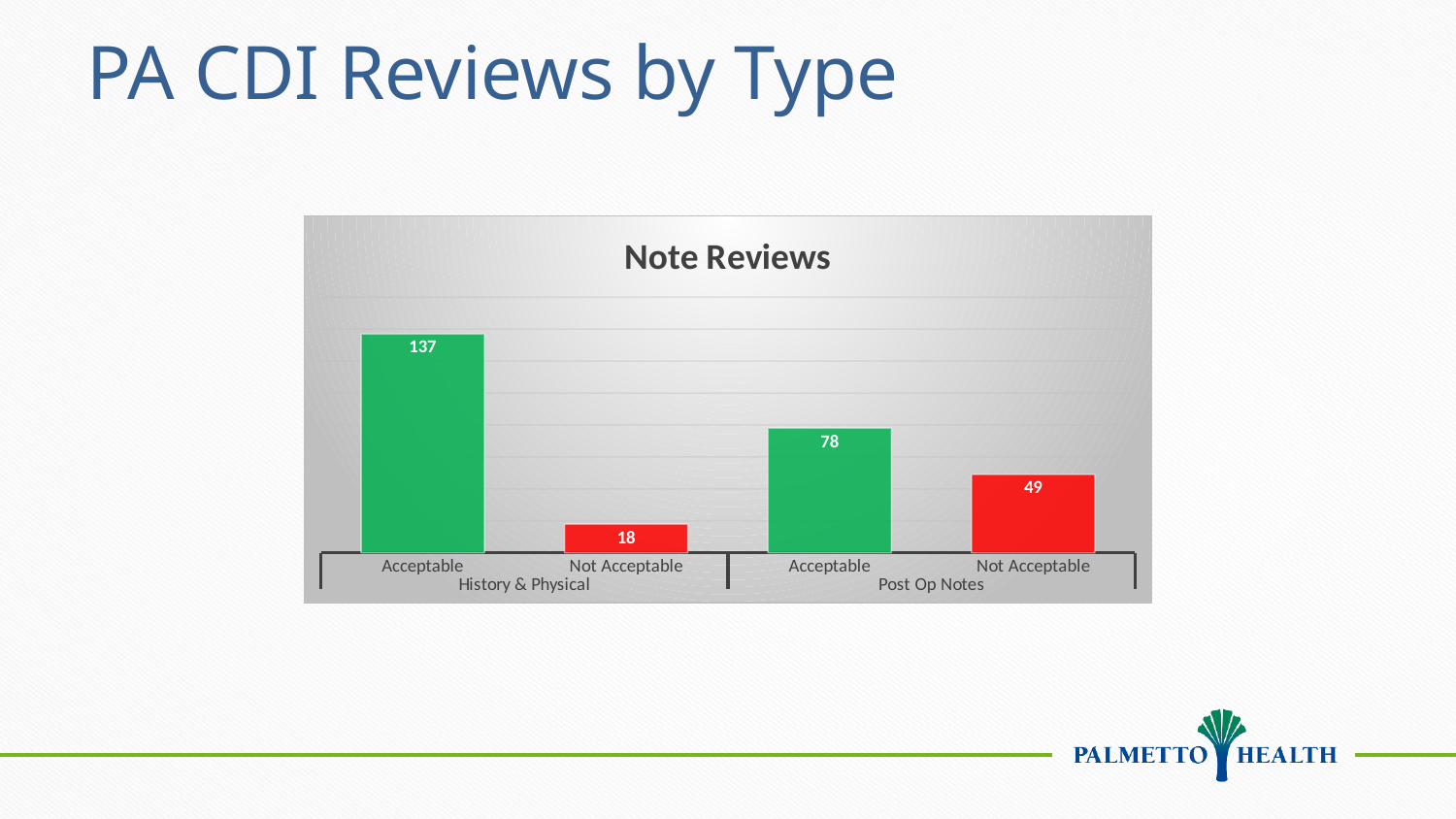
Which bar has the lowest value? Not Acceptable (History & Physical) Which is larger: Not Acceptable for History & Physical or Not Acceptable for Post Op Notes? Not Acceptable for Post Op Notes How many bars are plotted in the chart? 4 What is the value for Not Acceptable under Post Op Notes? 49 What is the difference between Acceptable and Not Acceptable for Post Op Notes? 29 What is the difference between Acceptable and Not Acceptable for History & Physical? 119 What is the title of the chart? Note Reviews What is the value for Acceptable under Post Op Notes? 78 What kind of chart is shown? Bar chart What is the value for Acceptable under History & Physical? 137 What is the value for Not Acceptable under History & Physical? 18 Which bar has the highest value? Acceptable (History & Physical)